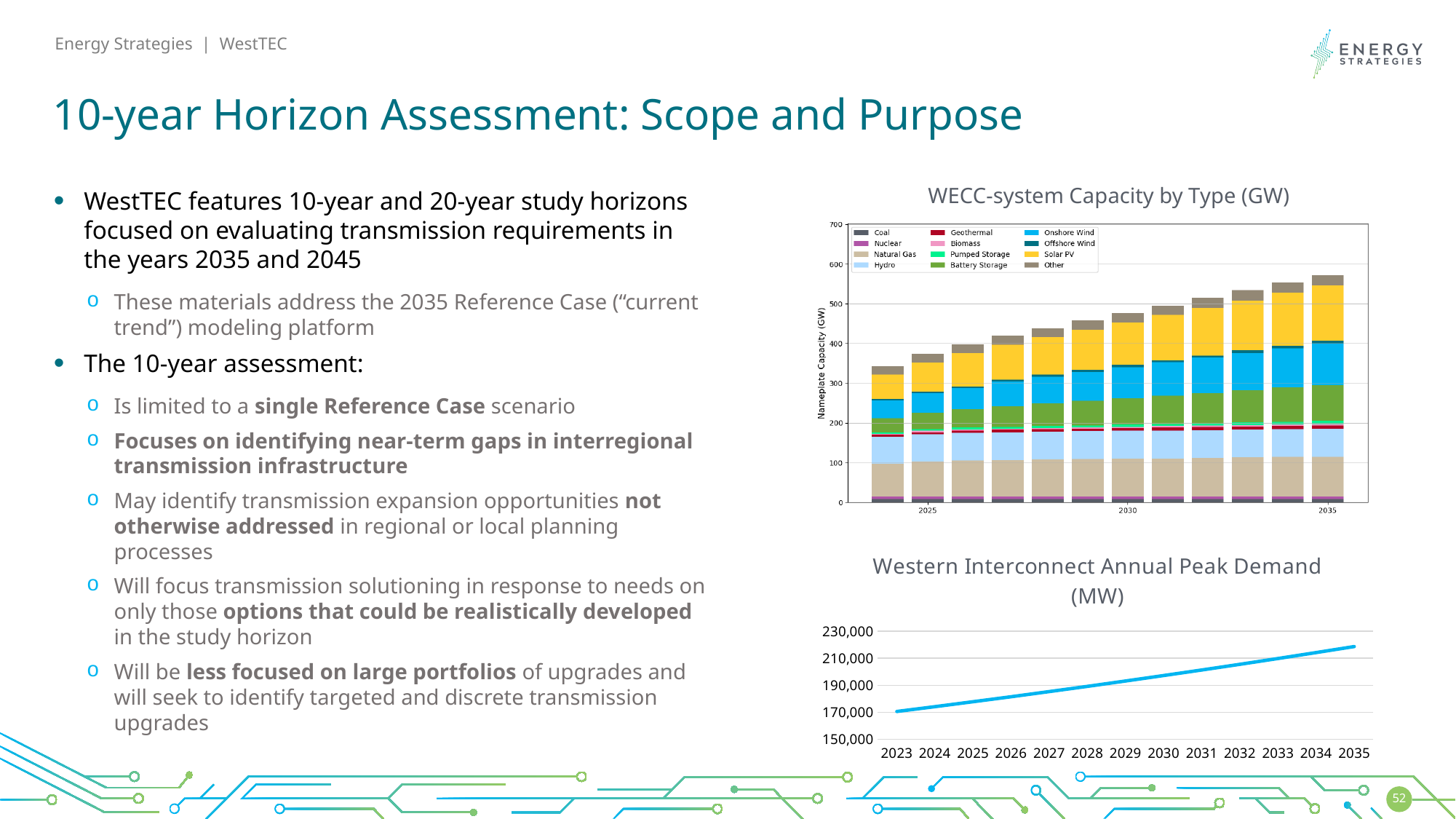
How many bars are plotted in the WECC-system Capacity by Type (GW) chart? 12 In the WECC-system Capacity by Type (GW) chart, is the total capacity for 2035 greater or less than 500? greater In the WECC-system Capacity by Type (GW) chart, what colour represents Solar PV in the legend? yellow How many series does the legend of the WECC-system Capacity by Type (GW) chart list? 12 In the Western Interconnect Annual Peak Demand (MW) chart, does peak demand rise or fall from 2023 to 2035? rise What kind of chart is the Western Interconnect Annual Peak Demand (MW) chart? line chart What kind of chart is the WECC-system Capacity by Type (GW) chart? stacked bar chart In the WECC-system Capacity by Type (GW) chart, which year has the shortest total bar? 2024 In the Western Interconnect Annual Peak Demand (MW) chart, is the value for 2035 greater or less than 200,000? greater In the WECC-system Capacity by Type (GW) chart, which year has the tallest total bar? 2035 How many years are shown on the x axis of the Western Interconnect Annual Peak Demand (MW) chart? 13